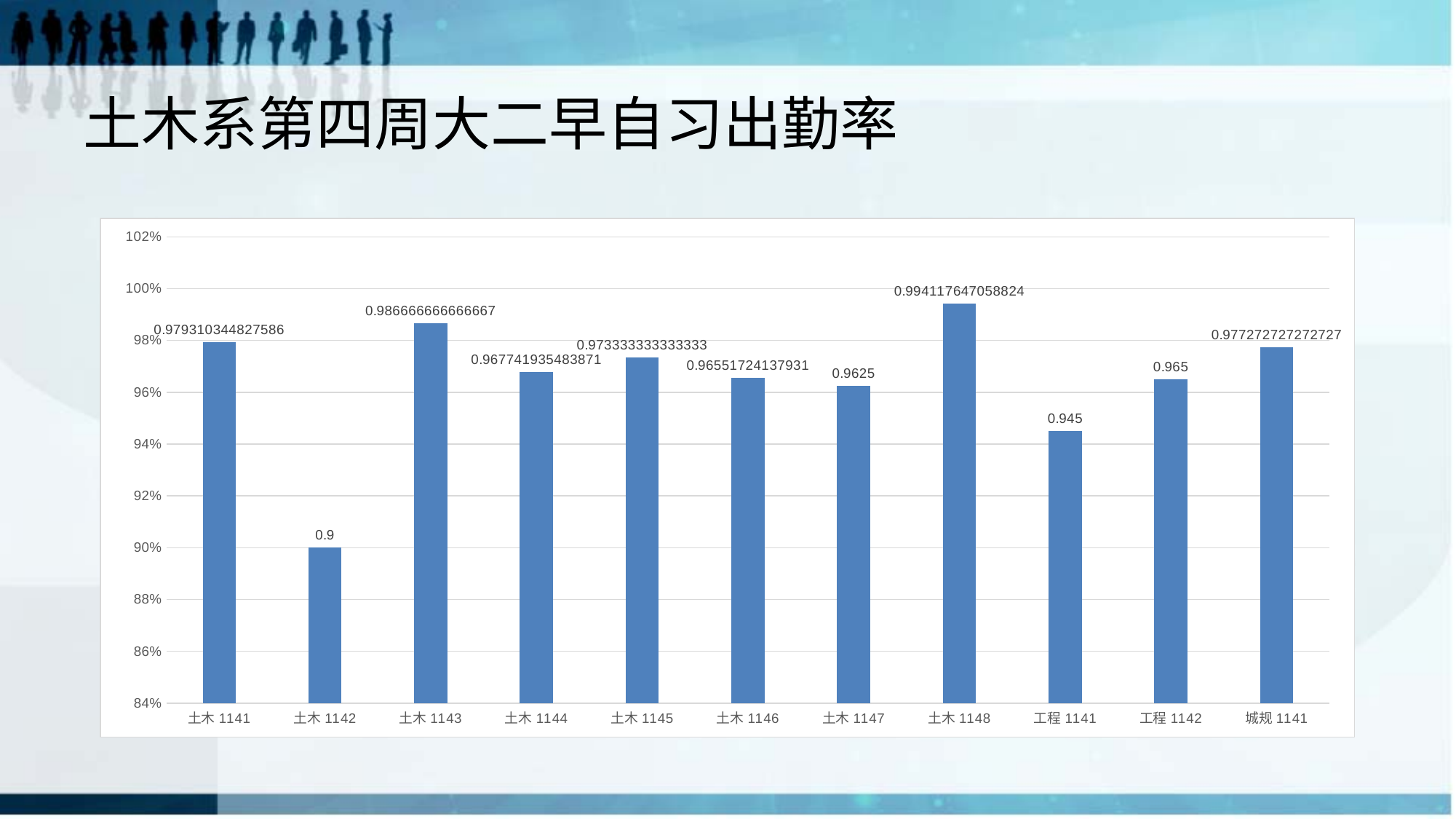
What is the value for 土木 1148? 0.994117647058824 Is the value for 土木 1142 greater or less than 92%? less What is the difference between the values for 工程 1142 and 工程 1141? 0.02 What is the value for 土木 1147? 0.9625 Which category has the highest value? 土木 1148 What is the title of the slide? 土木系第四周大二早自习出勤率 Which category has the lowest value? 土木 1142 How many categories are shown on the x axis? 11 What is the value for 土木 1142? 0.9 What is the value for 工程 1141? 0.945 Which is larger, the value for 土木 1143 or the value for 城规 1141? 土木 1143 What kind of chart is shown on the slide? bar chart